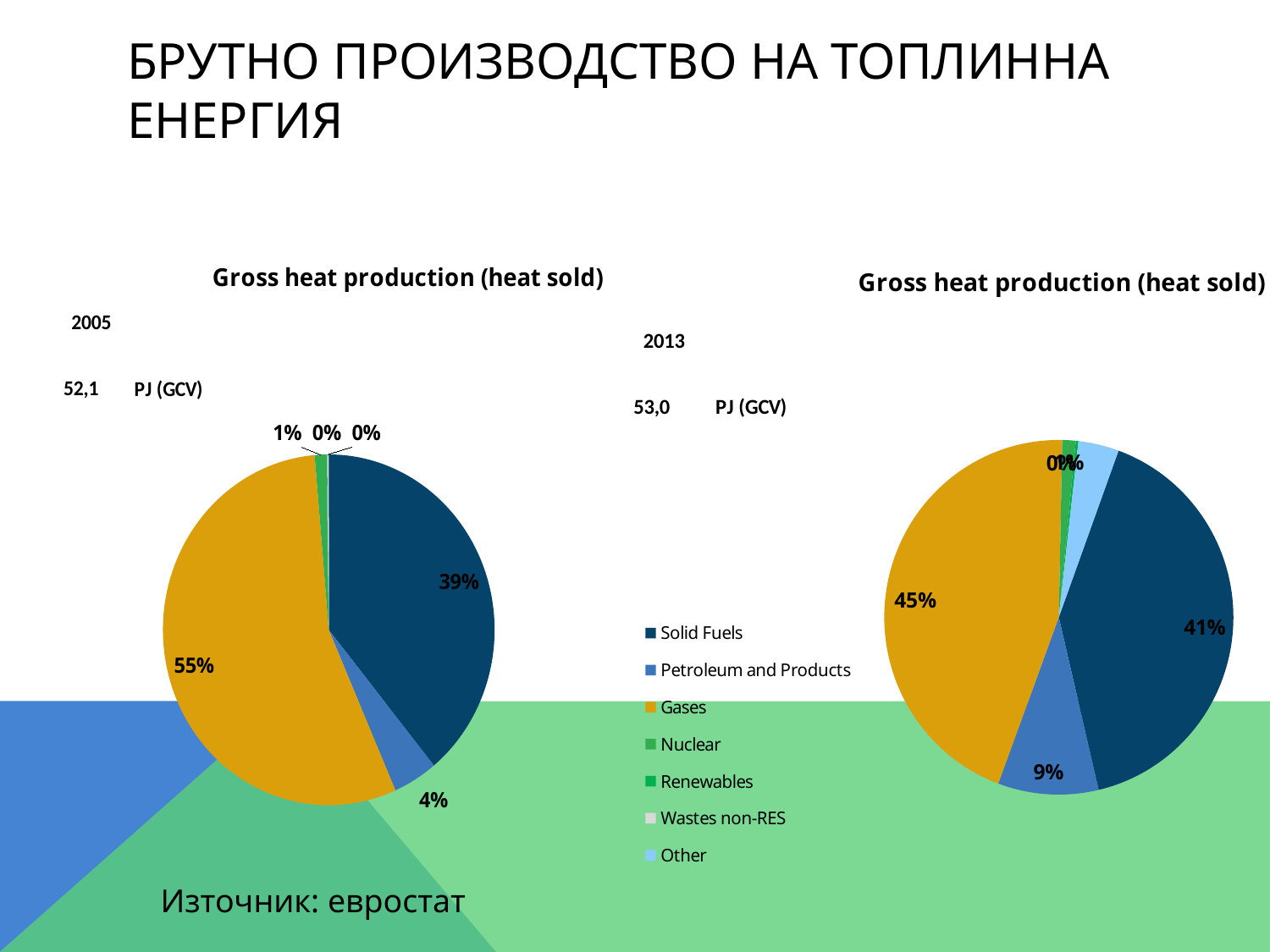
In the 2005 pie chart (left), what is the difference in percentage points between Gases and Solid Fuels? 16 percentage points What total gross heat production is shown for the 2005 chart (left)? 52,1 PJ (GCV) In the 2005 pie chart (left), which category has the largest share? Gases How many categories does the legend list? 7 In the 2005 pie chart (left), what share does Petroleum and Products have? 4% In the 2013 pie chart (right), which is larger: Solid Fuels or Petroleum and Products? Solid Fuels In the 2013 pie chart (right), what share does Solid Fuels have? 41% In the 2013 pie chart (right), which category has the largest share? Gases By how many percentage points did the share of Gases change between the 2005 chart and the 2013 chart? 10 percentage points In the 2013 pie chart (right), what share does Petroleum and Products have? 9% What type of chart is used on this slide? Pie chart In the 2005 pie chart (left), what share does Gases have? 55%